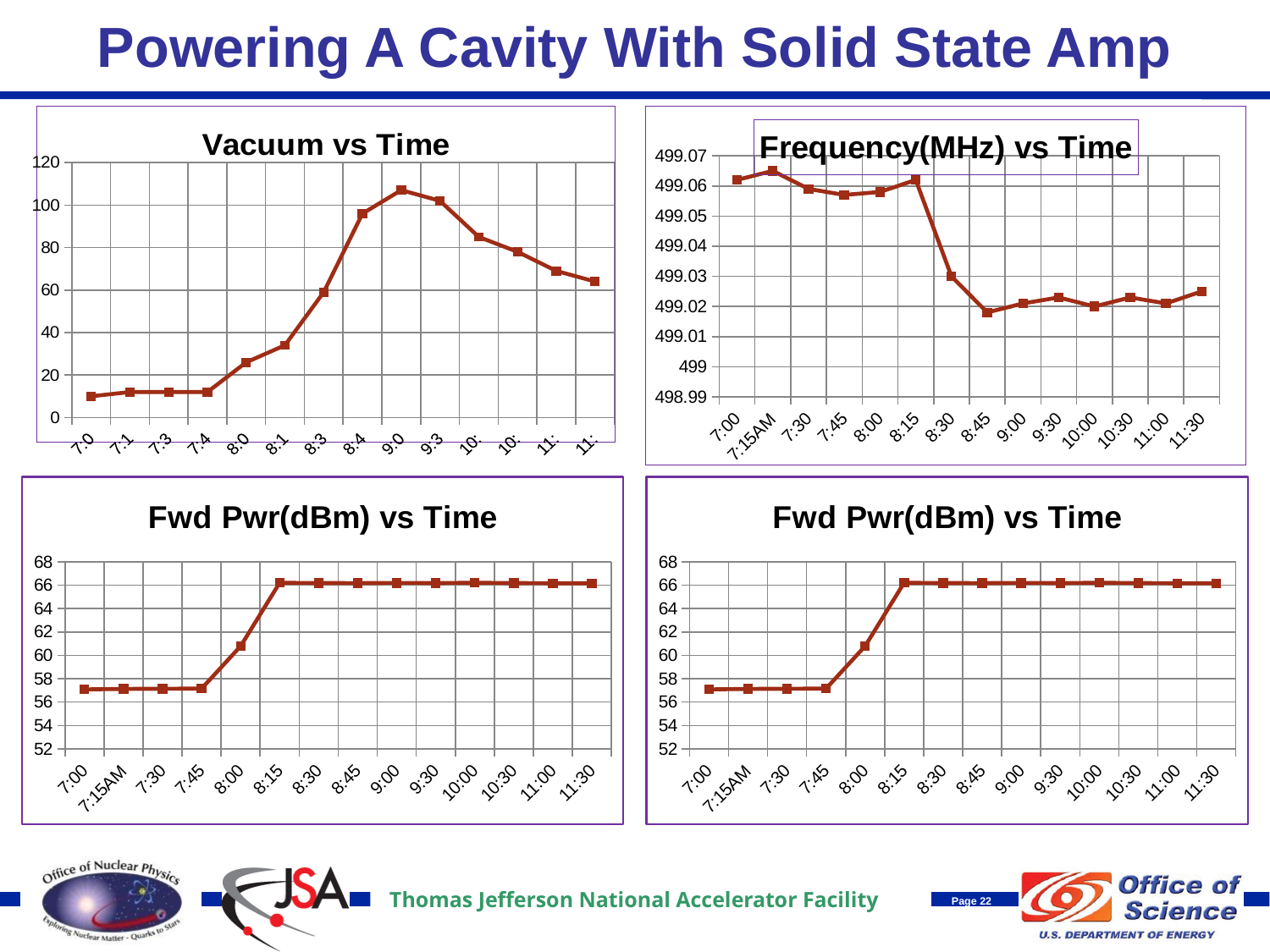
In the 'Frequency(MHz) vs Time' chart, which is larger, the value at 7:00 or the value at 11:30? 7:00 In the bottom-left 'Fwd Pwr(dBm) vs Time' chart, is the value at 7:00 greater or less than 58? less In the bottom-right 'Fwd Pwr(dBm) vs Time' chart, which is larger, the value at 8:00 or the value at 8:15? 8:15 In the 'Vacuum vs Time' chart, which x-axis category has the highest value? 9:0 What kind of chart is the 'Vacuum vs Time' chart? line chart In the 'Frequency(MHz) vs Time' chart, do the values overall rise or fall from 7:00 to 11:30? fall In the 'Vacuum vs Time' chart, is the value at 9:0 greater or less than 100? greater How many charts are shown on the slide? 4 In the 'Vacuum vs Time' chart, is the value at 7:0 greater or less than 20? less How many data points are plotted in the 'Frequency(MHz) vs Time' chart? 14